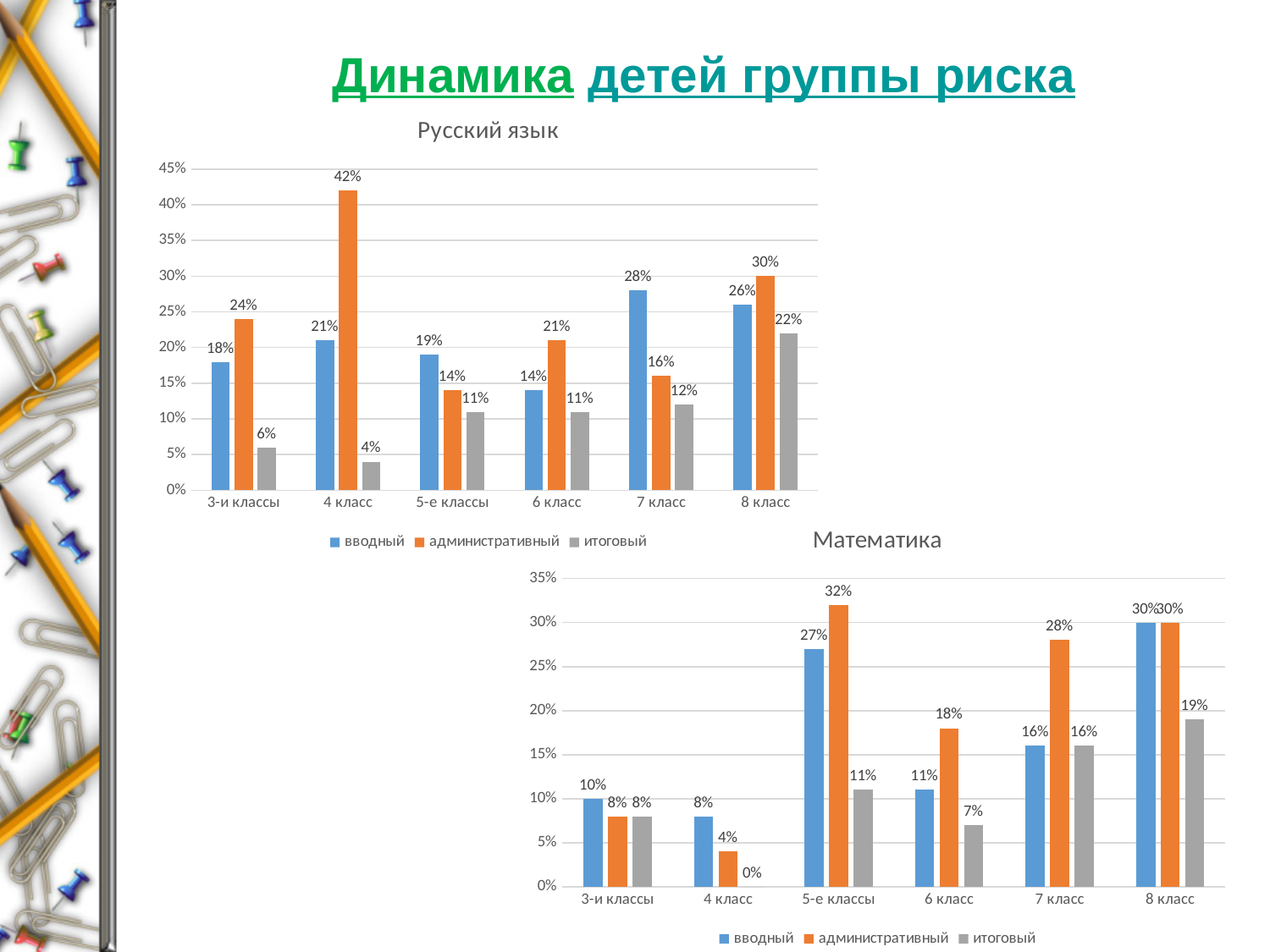
In the 'Математика' chart, what is the value for итоговый in 4 класс? 0% In the 'Русский язык' chart, what is the difference between the вводный and административный values for 4 класс? 21% In the 'Русский язык' chart, how many categories are shown on the x axis? 6 How many series does the legend of the 'Математика' chart list? 3 In the 'Математика' chart, what is the difference between the административный and итоговый values for 6 класс? 11% What kind of chart is the 'Математика' chart? bar chart In the 'Математика' chart, which category has the highest административный value? 5-е классы In the 'Русский язык' chart, what is the value for административный in 4 класс? 42% In the 'Русский язык' chart, what is the value for итоговый in 8 класс? 22% In the 'Русский язык' chart, which category has the lowest итоговый value? 4 класс In the 'Математика' chart, what is the value for административный in 5-е классы? 32% In the 'Русский язык' chart, which is larger for 7 класс: вводный or административный? вводный